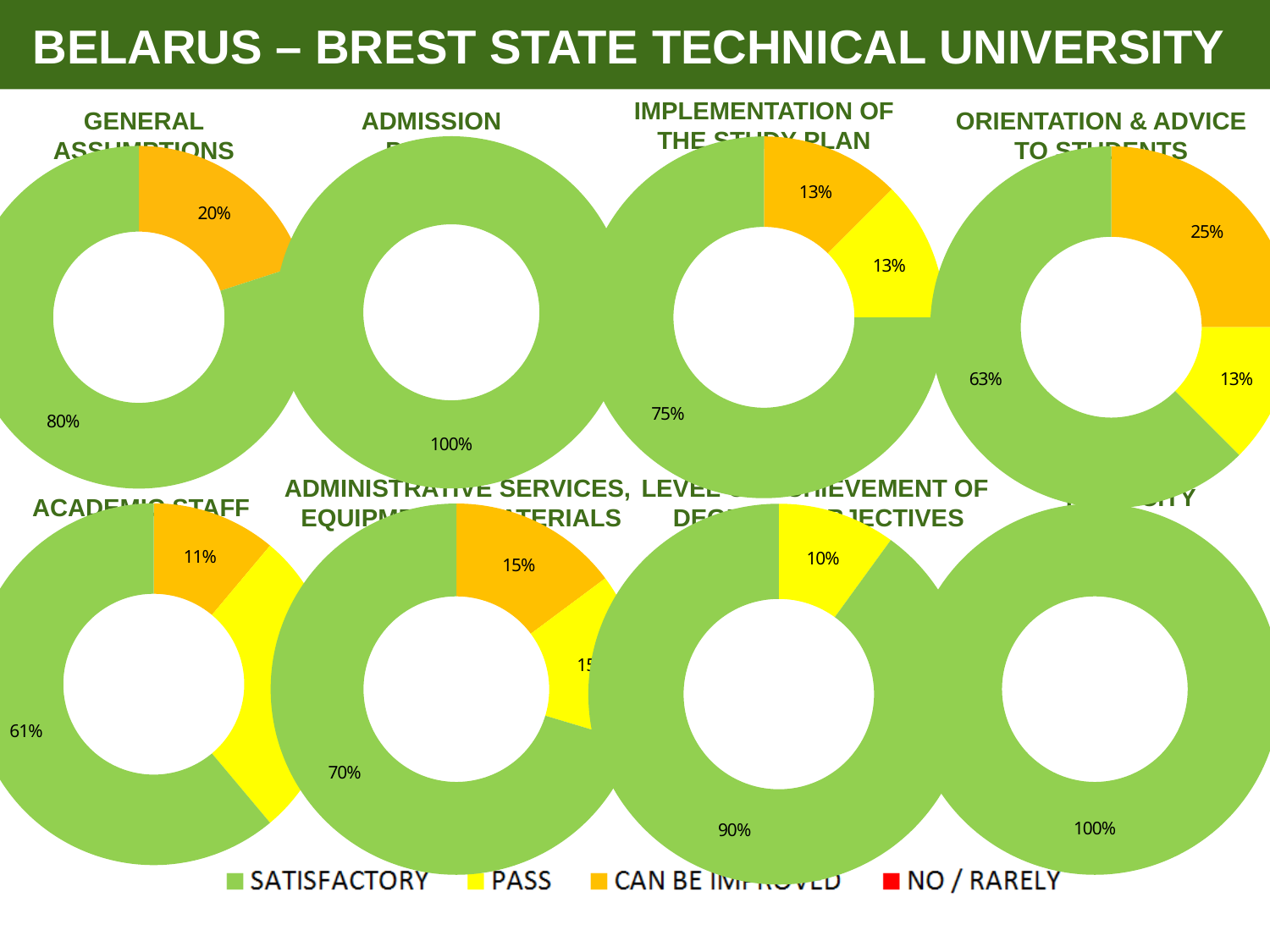
What kind of chart is used for GENERAL ASSUMPTIONS? Doughnut chart In the LEVEL OF ACHIEVEMENT OF DEGREE OBJECTIVES chart, what percentage is PASS? 10% Which colour represents SATISFACTORY in the legend? Green In the GENERAL ASSUMPTIONS chart, what is the difference between the SATISFACTORY and CAN BE IMPROVED percentages? 60% In the ORIENTATION & ADVICE TO STUDENTS chart, what percentage is SATISFACTORY? 63% In the ORIENTATION & ADVICE TO STUDENTS chart, what percentage is CAN BE IMPROVED? 25% In the IMPLEMENTATION OF THE STUDY PLAN chart, what percentage is SATISFACTORY? 75% In the ORIENTATION & ADVICE TO STUDENTS chart, which is larger, the CAN BE IMPROVED slice or the PASS slice? CAN BE IMPROVED In the ACADEMIC STAFF chart, what percentage is CAN BE IMPROVED? 11% How many categories does the legend at the bottom of the slide list? 4 In the GENERAL ASSUMPTIONS chart, what percentage is shown for the SATISFACTORY slice? 80% In the GENERAL ASSUMPTIONS chart, what percentage is shown for the CAN BE IMPROVED slice? 20%